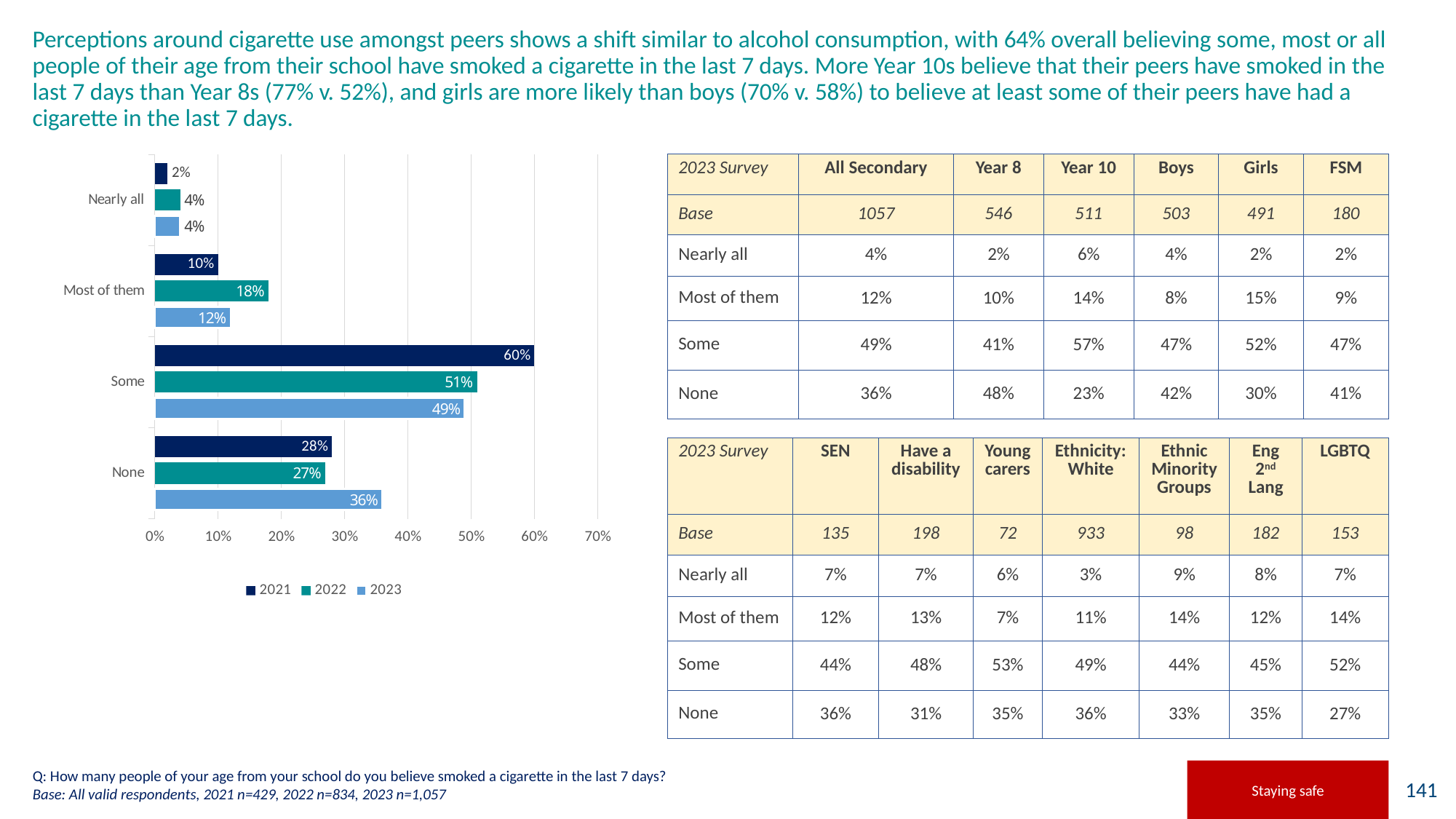
What is the 2023 value for 'Some' in the chart? 49% Which is larger in the chart: the 2023 value for 'None' or the 2021 value for 'None'? 2023 Which series in the chart legend is shown in the darkest blue colour? 2021 What is the 2022 value for 'Most of them' in the chart? 18% How many series does the chart legend list? 3 How many categories are shown on the chart's vertical axis? 4 What is the 2021 value for 'None' in the chart? 28% What kind of chart is shown on the slide? Bar chart Is the 2022 value for 'Some' in the chart greater or less than 40%? greater Which category has the lowest 2023 value in the chart? Nearly all Which category has the highest 2021 value in the chart? Some What is the difference between the 2021 and 2023 values for 'Some' in the chart? 11%